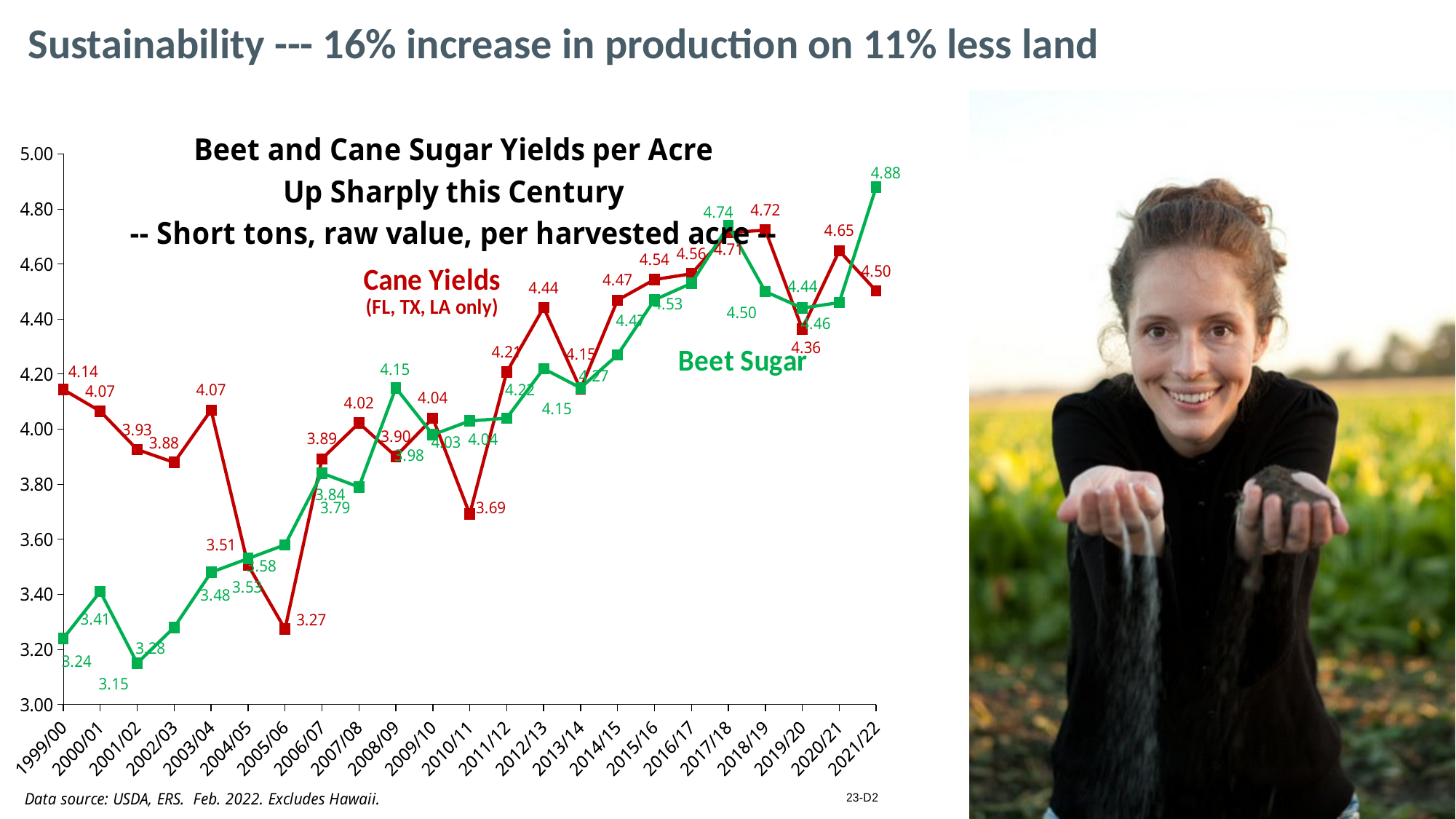
Overall, do the beet sugar yields rise or fall from 1999/00 to 2021/22? rise How many crop years are shown along the x axis? 23 What kind of chart is shown on the slide? line chart In which crop year was the cane yield highest? 2018/19 By how much did the beet sugar yield increase from 1999/00 to 2021/22? 1.64 What was the cane yield in 2010/11? 3.69 Which states are included in the cane yields series? FL, TX, LA only How many series are plotted on the chart? 2 In 2012/13, which was higher, the cane yield or the beet sugar yield? Cane yield In which crop year was the beet sugar yield lowest? 2001/02 What was the cane yield in 2005/06? 3.27 What was the beet sugar yield in 2021/22? 4.88